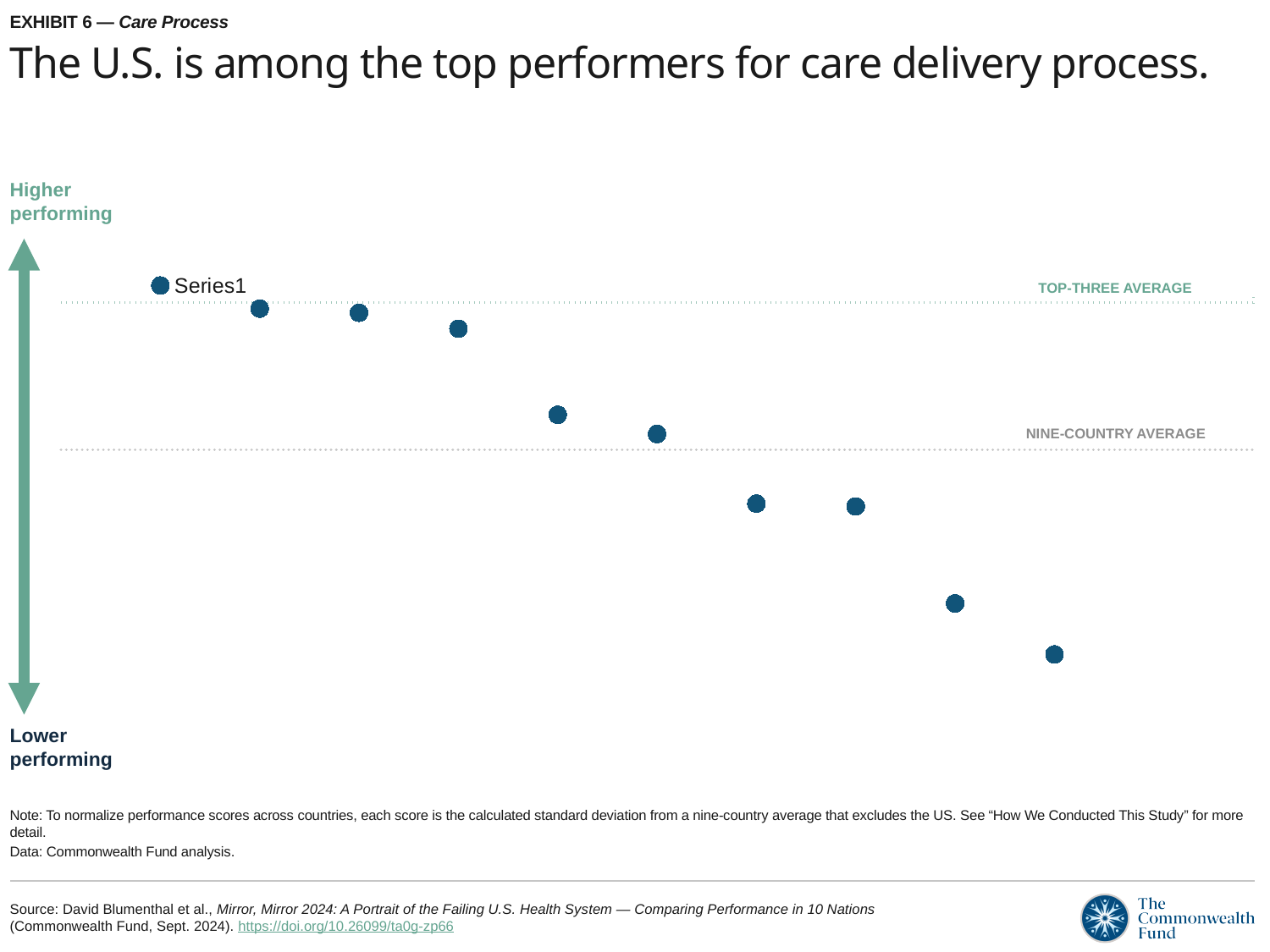
What are the labels of the two dotted reference lines on the chart? TOP-THREE AVERAGE and NINE-COUNTRY AVERAGE Do the plotted values rise or fall from left to right along the x axis? fall Is the leftmost plotted point above or below the NINE-COUNTRY AVERAGE line? above Is the rightmost point on the chart above or below the NINE-COUNTRY AVERAGE line? below What kind of chart is shown on the slide? scatter chart Which reference line is positioned higher on the chart, TOP-THREE AVERAGE or NINE-COUNTRY AVERAGE? TOP-THREE AVERAGE